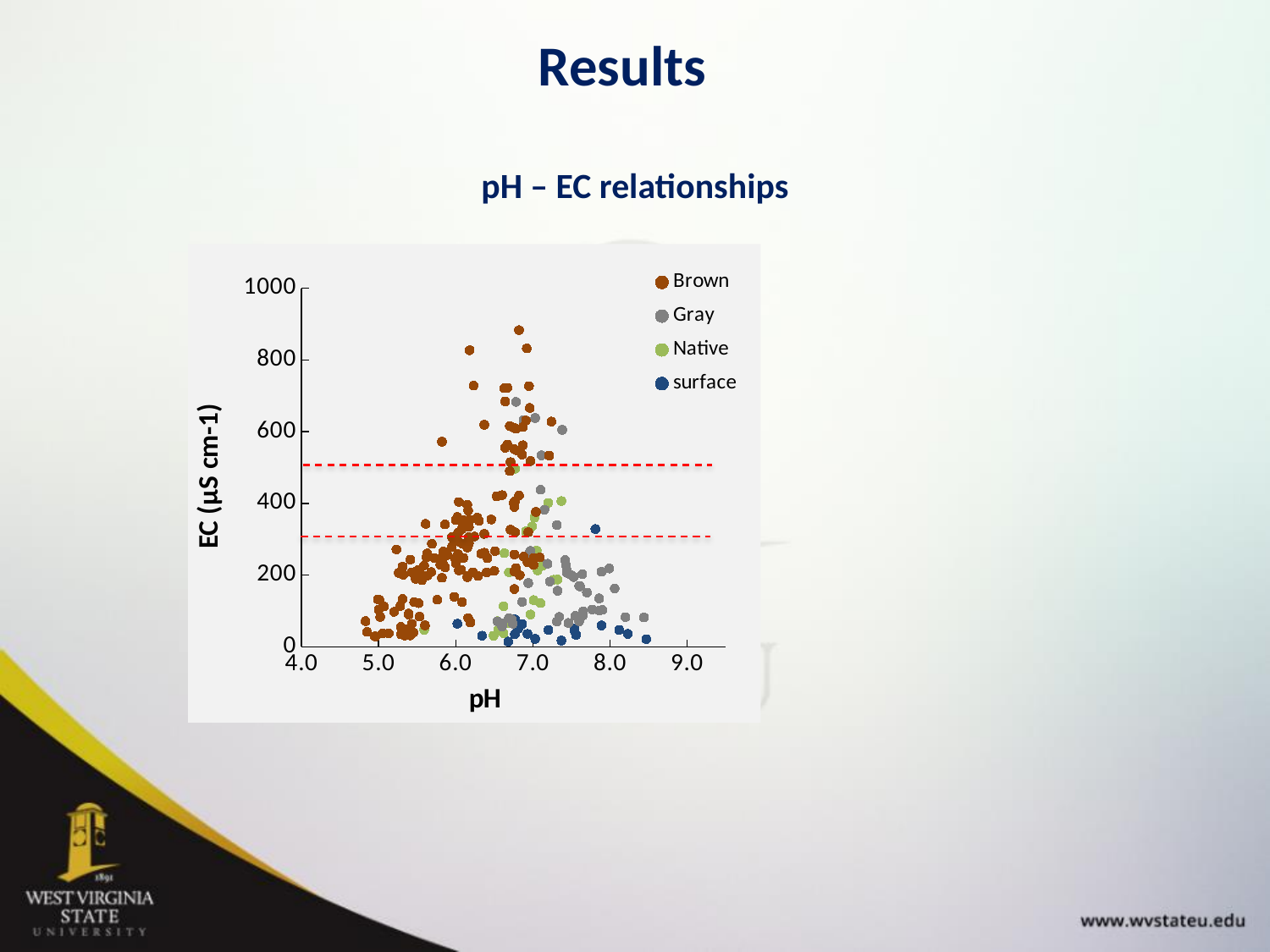
Is the highest EC value for the Gray series greater or less than 800? less Is the highest EC value for the Brown series greater or less than 800? greater Which series reaches a higher maximum EC value, Brown or surface? Brown What kind of chart is shown on the slide? scatter plot What are the series names listed in the legend? Brown, Gray, Native, surface How many series does the legend list? 4 Which series contains the point with the highest EC value? Brown How many red dashed horizontal lines are drawn on the chart? 2 What is the title of the chart? pH – EC relationships Is the highest EC value for the surface series greater or less than 400? less Which series contains the points with the lowest pH values? Brown What is the maximum value shown on the EC (y) axis? 1000